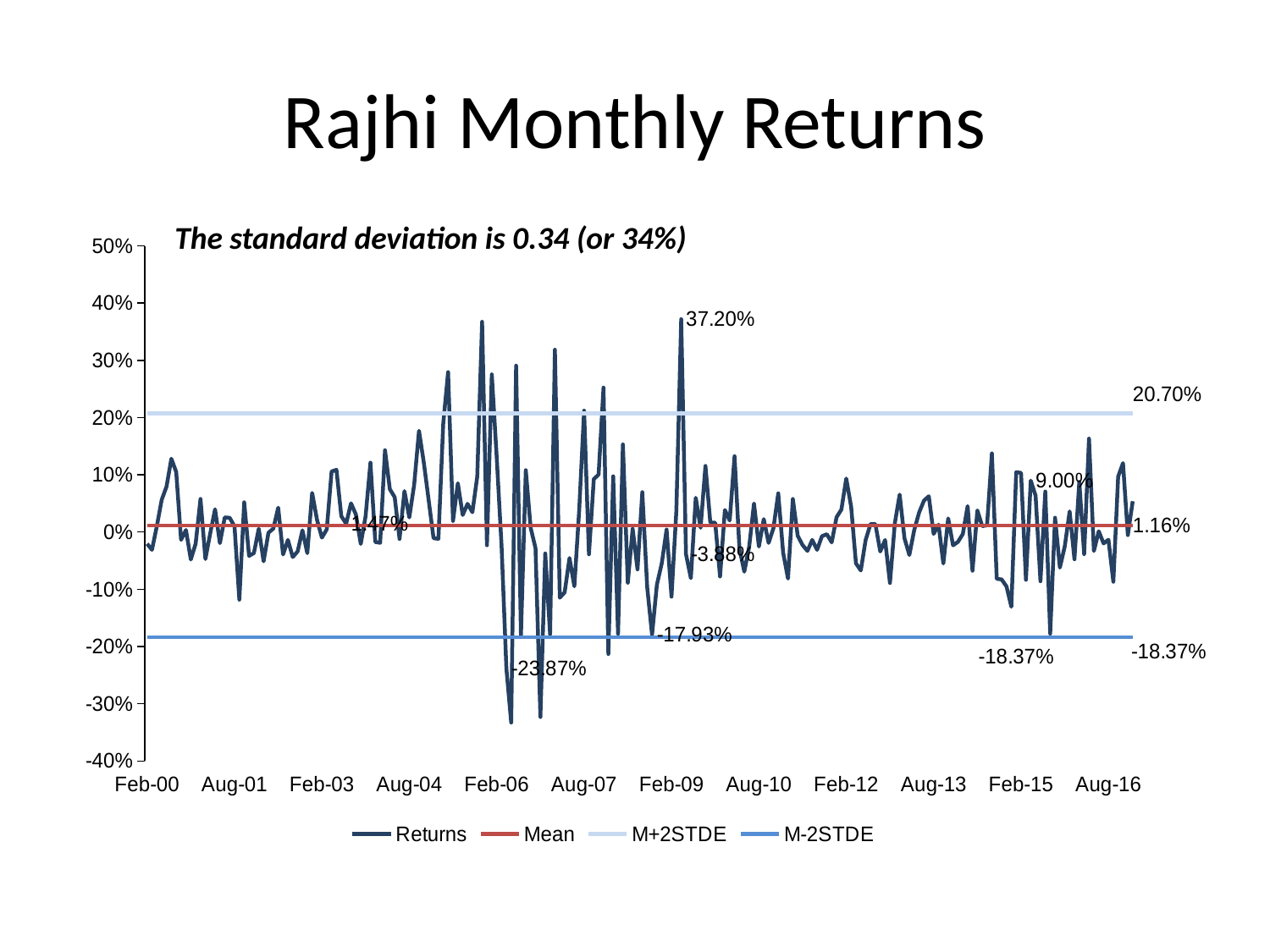
What is the difference between the M+2STDE value (20.70%) and the Mean value (1.16%)? 19.54% How many series does the legend list? 4 According to the text on the chart, what is the standard deviation? 0.34 (or 34%) What is the title of the chart? Rajhi Monthly Returns What kind of chart is shown on the slide? line chart Is the Mean line greater or less than 0%? greater What value is labelled on the Mean line? 1.16% What is the lowest labelled value on the Returns series? -23.87% What is the difference between the peak labelled return of 37.20% and the M+2STDE line at 20.70%? 16.50% What is the highest labelled value on the Returns series? 37.20% What value is labelled on the M+2STDE line? 20.70% What value is labelled on the M-2STDE line? -18.37%